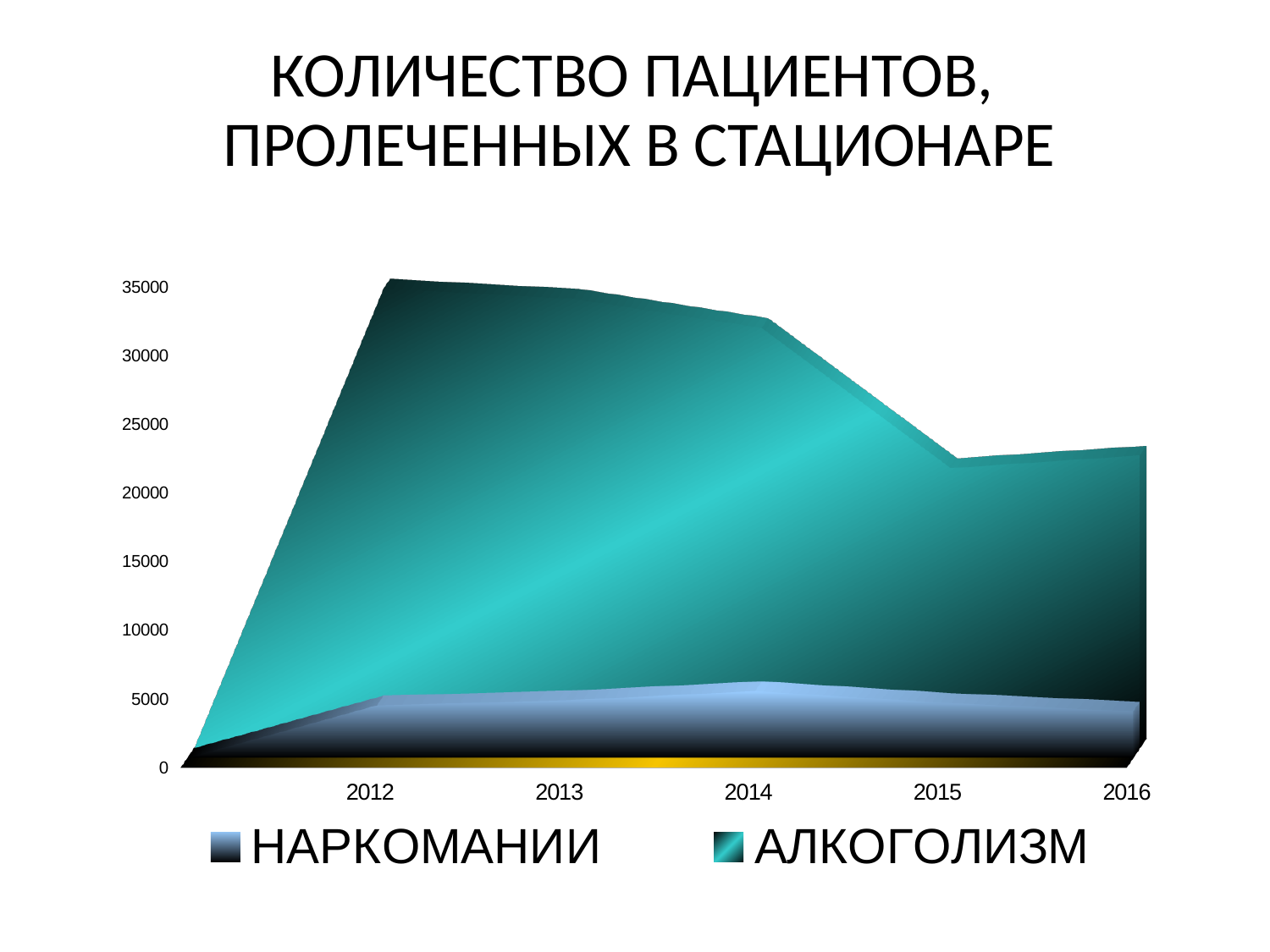
Which series has the larger value in 2014, НАРКОМАНИИ or АЛКОГОЛИЗМ? АЛКОГОЛИЗМ How many series does the legend list? 2 Which series is shown in teal/green? АЛКОГОЛИЗМ Is the value for АЛКОГОЛИЗМ in 2012 greater or less than 30000? greater Does the value for АЛКОГОЛИЗМ rise or fall from 2012 to 2015? fall Is the value for АЛКОГОЛИЗМ in 2014 greater or less than 30000? greater What is the title of the chart? КОЛИЧЕСТВО ПАЦИЕНТОВ, ПРОЛЕЧЕННЫХ В СТАЦИОНАРЕ How many years are shown on the x axis? 5 Is the value for НАРКОМАНИИ in 2012 greater or less than 10000? less What kind of chart is shown on the slide? Area chart In which year is the value for АЛКОГОЛИЗМ highest? 2012